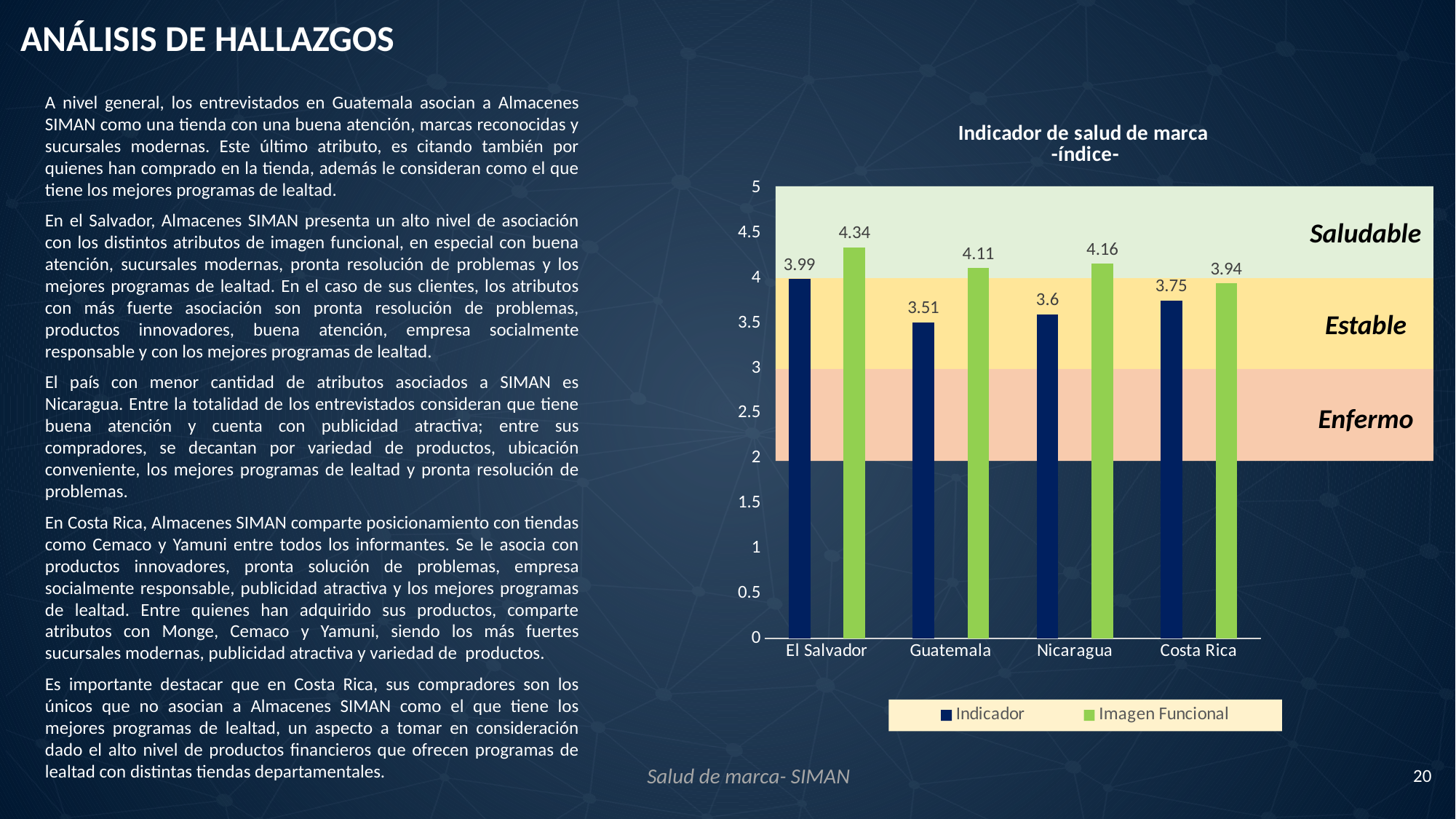
What is the Indicador value for El Salvador? 3.99 Which is larger for Costa Rica, the Indicador value or the Imagen Funcional value? Imagen Funcional How many series does the chart legend list? 2 How many countries are shown on the x axis of the chart? 4 What is the title of the chart? Indicador de salud de marca -índice- What is the difference between the Imagen Funcional and Indicador values for Nicaragua? 0.56 What kind of chart is shown on the slide? bar chart Is the Indicador value for Guatemala greater or less than 4? less What is the Imagen Funcional value for Guatemala? 4.11 Which country has the lowest Indicador value? Guatemala What is the Indicador value for Costa Rica? 3.75 Which country has the highest Imagen Funcional value? El Salvador